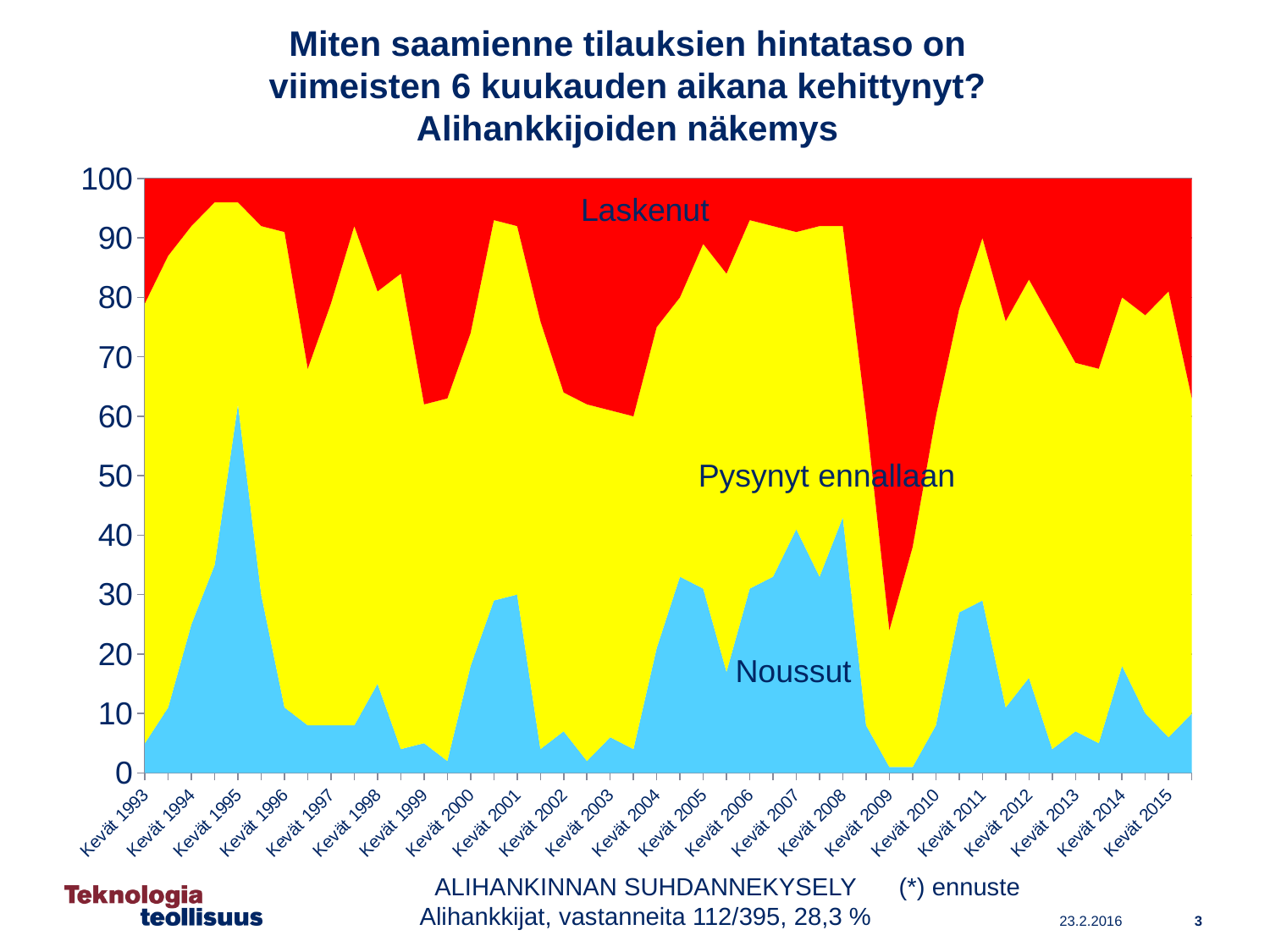
What kind of chart is shown on the slide? Stacked area chart At which x-axis label does the Noussut series reach its highest value? Kevät 1995 Does the Noussut series rise or fall from Kevät 1993 to Kevät 1995? rise How many labelled time points are shown on the x axis? 23 How many series are plotted in the chart? 3 Is the value for Noussut at Kevät 2009 greater or less than 10? less Which is larger, the Noussut value at Kevät 1995 or at Kevät 2009? Kevät 1995 At which x-axis label does the Laskenut series reach its highest share? Kevät 2009 Is the share for Laskenut at Kevät 2009 greater or less than 50? greater Is the value for Noussut at Kevät 1995 greater or less than 50? greater Which series is plotted at the bottom of the stack? Noussut Which series is drawn in red? Laskenut